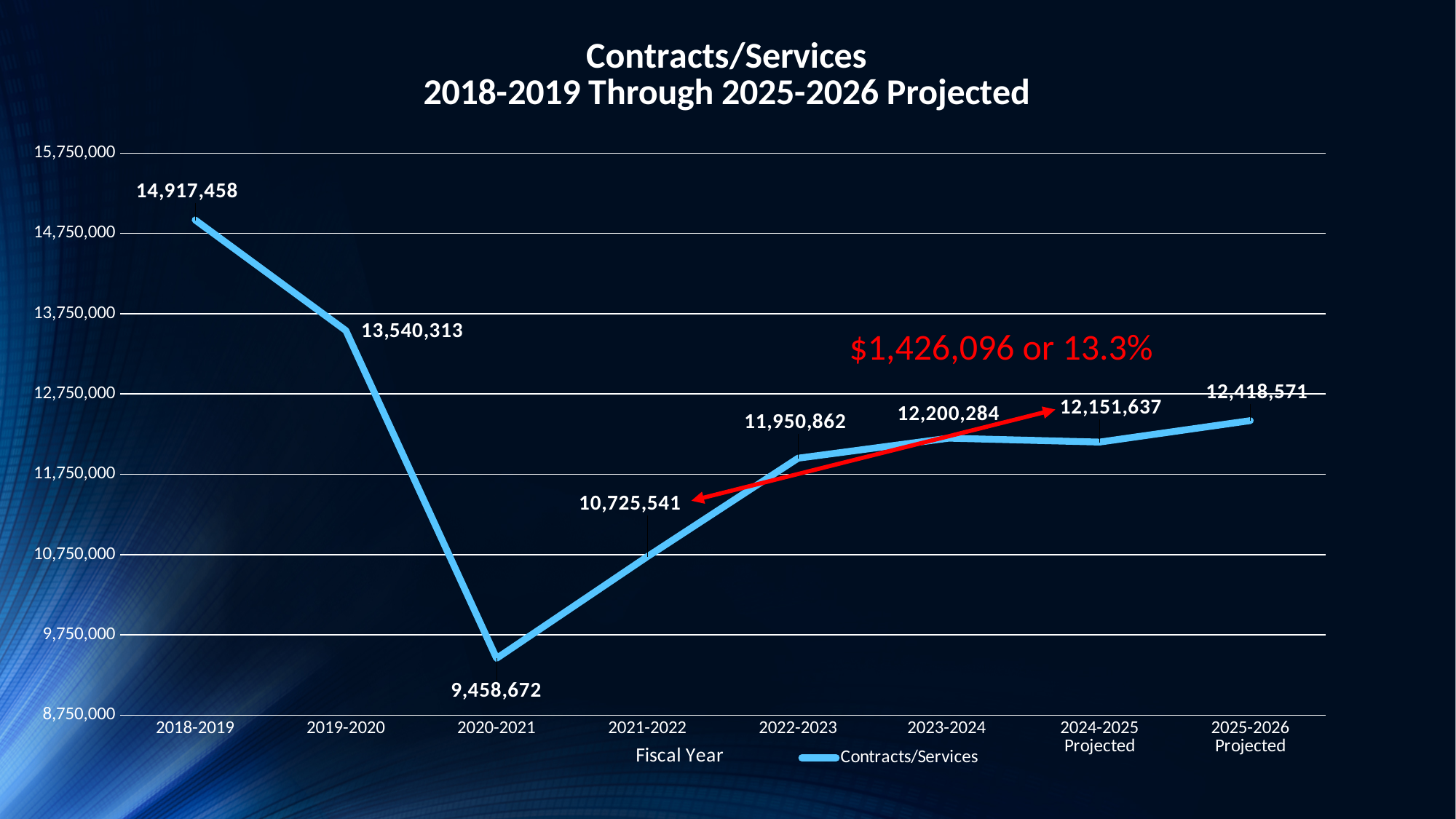
Which fiscal year has the lowest Contracts/Services value? 2020-2021 What is the projected Contracts/Services value for 2025-2026? 12,418,571 What is the difference between the 2018-2019 value and the 2019-2020 value? 1,377,145 Do the values rise or fall from 2018-2019 to 2020-2021? Fall Which fiscal year has the highest Contracts/Services value? 2018-2019 What is the difference between the 2025-2026 Projected value and the 2024-2025 Projected value? 266,934 How many fiscal years are plotted on the chart? 8 How many series does the legend list? 1 What kind of chart is shown on the slide? Line chart What is the Contracts/Services value for 2018-2019? 14,917,458 What is the Contracts/Services value for 2020-2021? 9,458,672 Which is larger, the value for 2023-2024 or the value for 2024-2025 Projected? 2023-2024